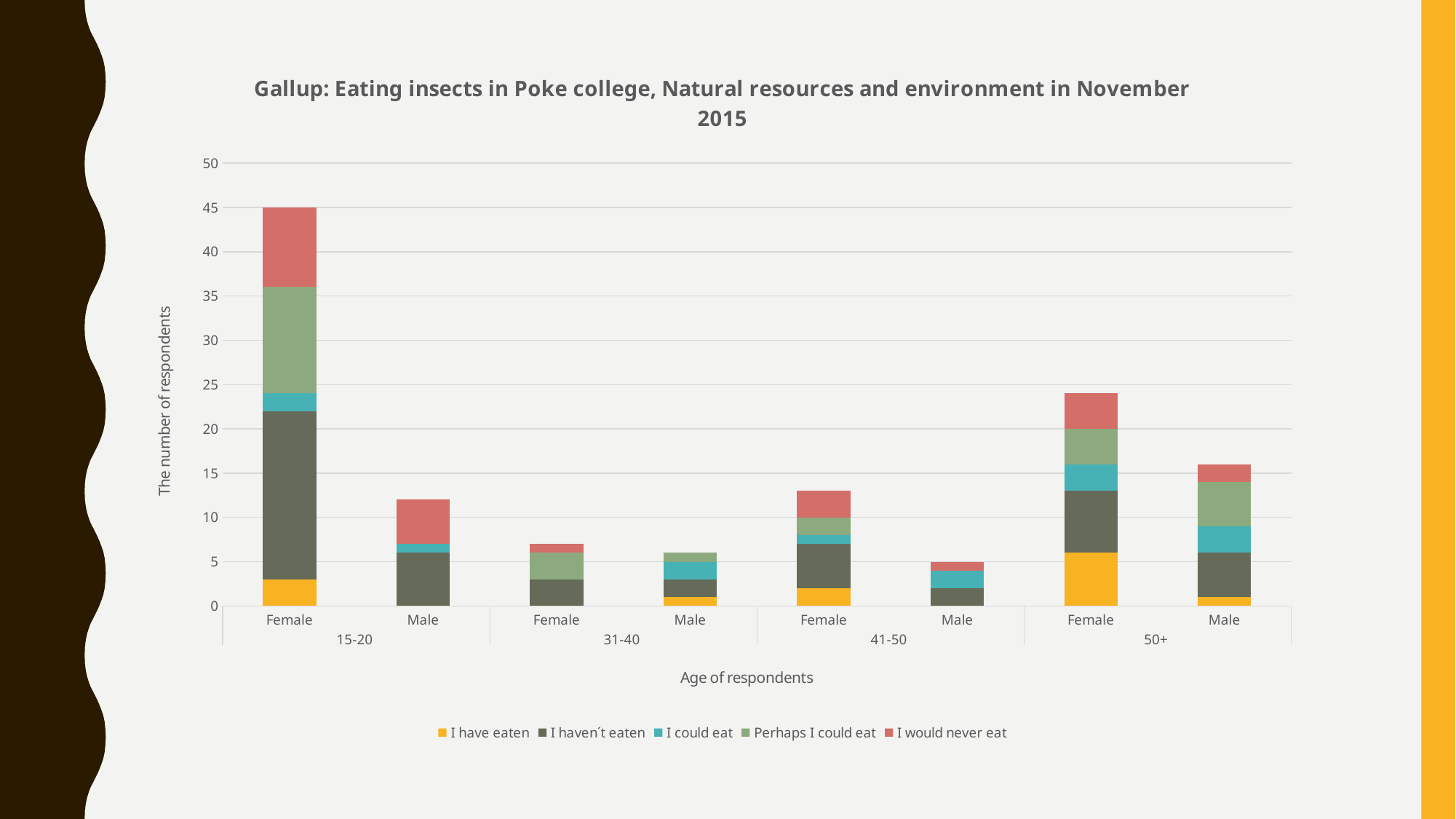
How many age groups are shown on the x axis? 4 In the 50+ age group, which bar is taller, Female or Male? Female Is the total for the Female 31-40 bar greater or less than 10? less How many stacked bars are plotted in the chart? 8 Which bar has the highest total number of respondents? Female, 15-20 Is the total for the Male 15-20 bar greater or less than 10? greater What is the total number of respondents for the Male 41-50 bar? 5 How many series does the legend list? 5 What is the label of the y axis? The number of respondents What is the total number of respondents for the Female 15-20 bar? 45 What kind of chart is shown on the slide? Stacked bar chart Is the total for the Female 50+ bar greater or less than 20? greater